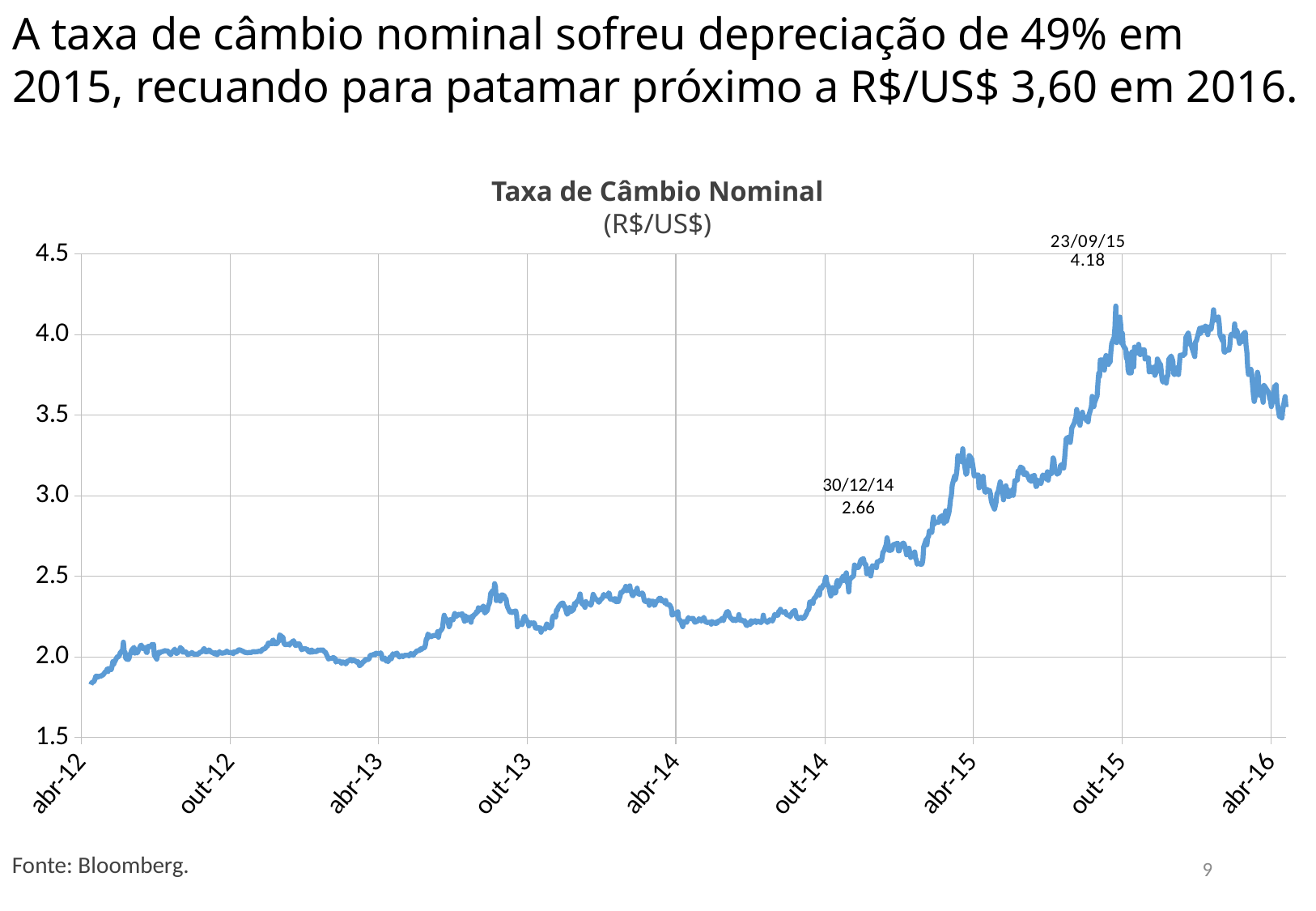
Overall, does the exchange rate rise or fall from abr-12 to abr-16? rise What type of chart is shown on the slide? line chart What unit is shown in the chart subtitle? R$/US$ Is the value at abr-12 greater or less than 2.0? less What value is labelled on the chart for 30/12/14? 2.66 Is the value at abr-16 greater or less than 4.0? less What value is labelled on the chart for 23/09/15? 4.18 What is the difference between the labelled values for 23/09/15 and 30/12/14? 1.52 Which labelled date has the higher value, 23/09/15 or 30/12/14? 23/09/15 What is the title of the chart? Taxa de Câmbio Nominal Is the value at abr-14 greater or less than 2.0? greater